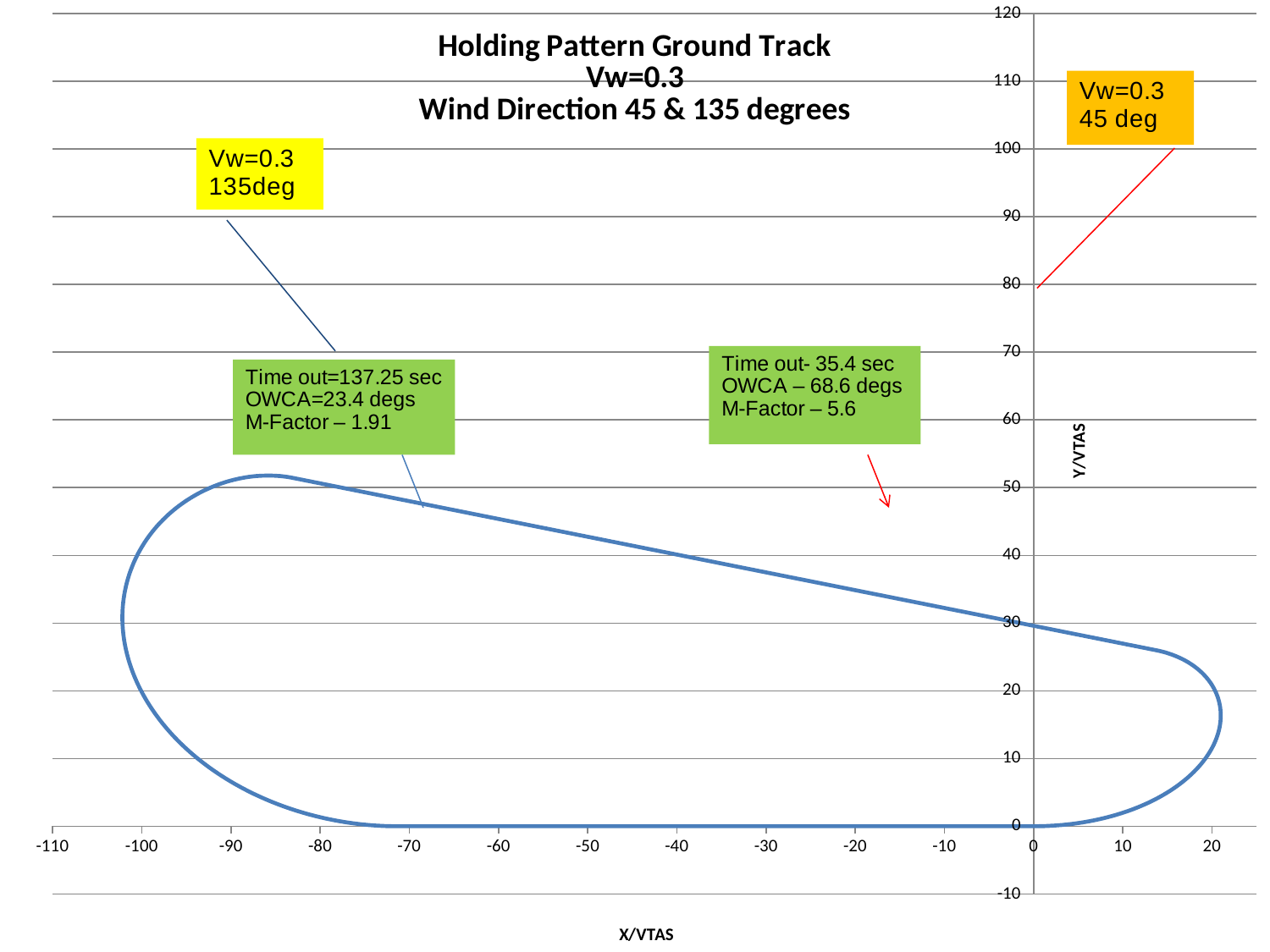
Is the highest Y/VTAS value reached by the ground track greater or less than 50? greater Is the highest Y/VTAS value reached by the ground track greater or less than 60? less Is the leftmost point of the ground track at an X/VTAS value greater or less than -100? less What is the maximum value shown on the vertical axis of the chart? 120 What kind of chart is shown on the slide? line chart What is the title of the chart? Holding Pattern Ground Track Vw=0.3 Wind Direction 45 & 135 degrees Along the upper leg of the ground track, does the Y/VTAS value rise or fall as X/VTAS increases from -80 to 0? fall What is the label on the horizontal axis of the chart? X/VTAS Which is larger: the Y/VTAS value of the ground track at X/VTAS = -80 on the upper leg, or at X/VTAS = 10 on the upper leg? X/VTAS = -80